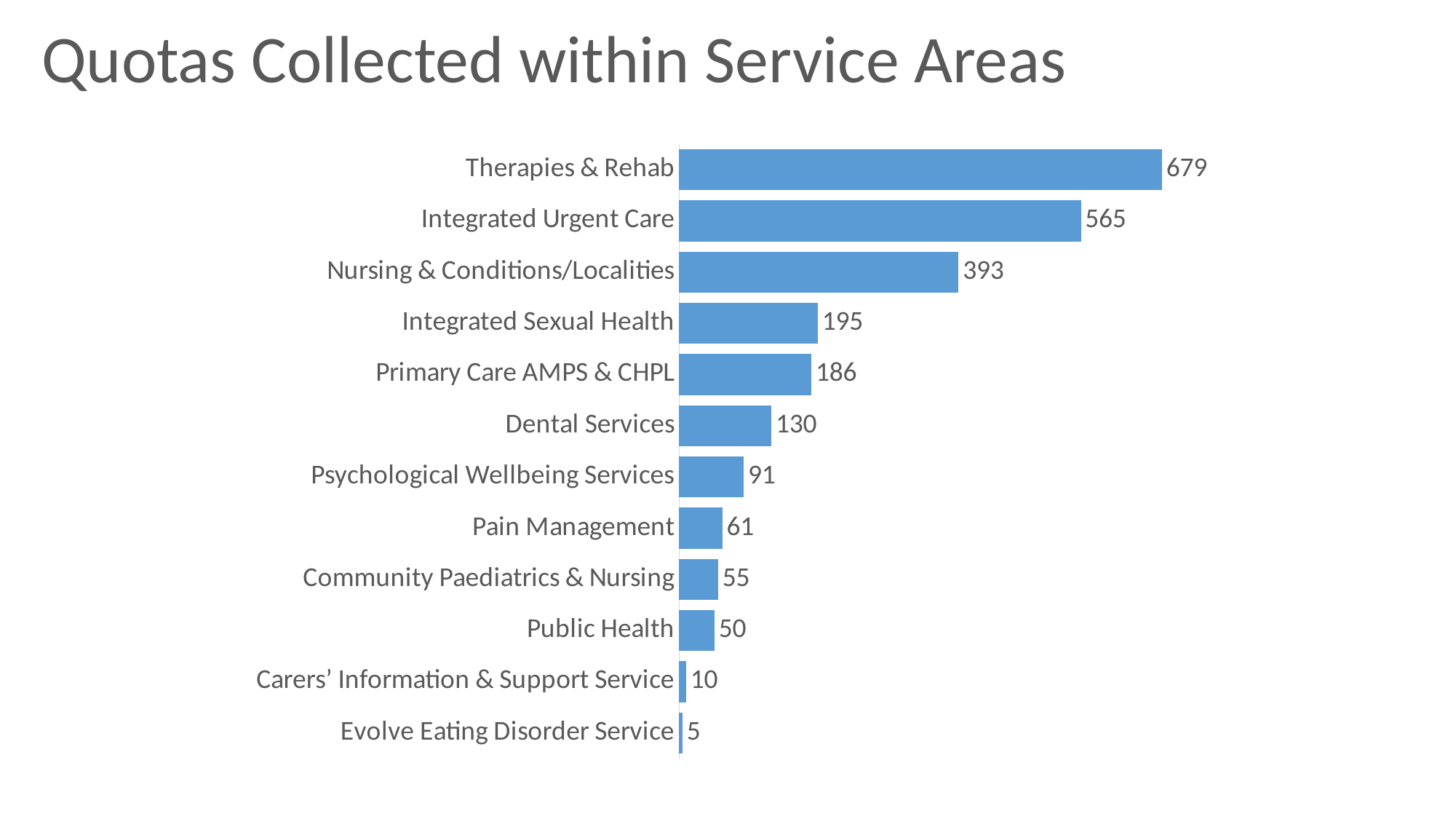
Which is larger, Pain Management or Public Health? Pain Management What is the value for Therapies & Rehab? 679 What is the difference between Integrated Sexual Health and Primary Care AMPS & CHPL? 9 What is the value for Carers' Information & Support Service? 10 Which service area has the lowest value? Evolve Eating Disorder Service What kind of chart is shown on the slide? Bar chart What is the value for Dental Services? 130 Which service area has the highest value? Therapies & Rehab What is the difference between Therapies & Rehab and Integrated Urgent Care? 114 How many service areas are shown in the chart? 12 What is the title of the chart? Quotas Collected within Service Areas Which is larger, Nursing & Conditions/Localities or Integrated Sexual Health? Nursing & Conditions/Localities